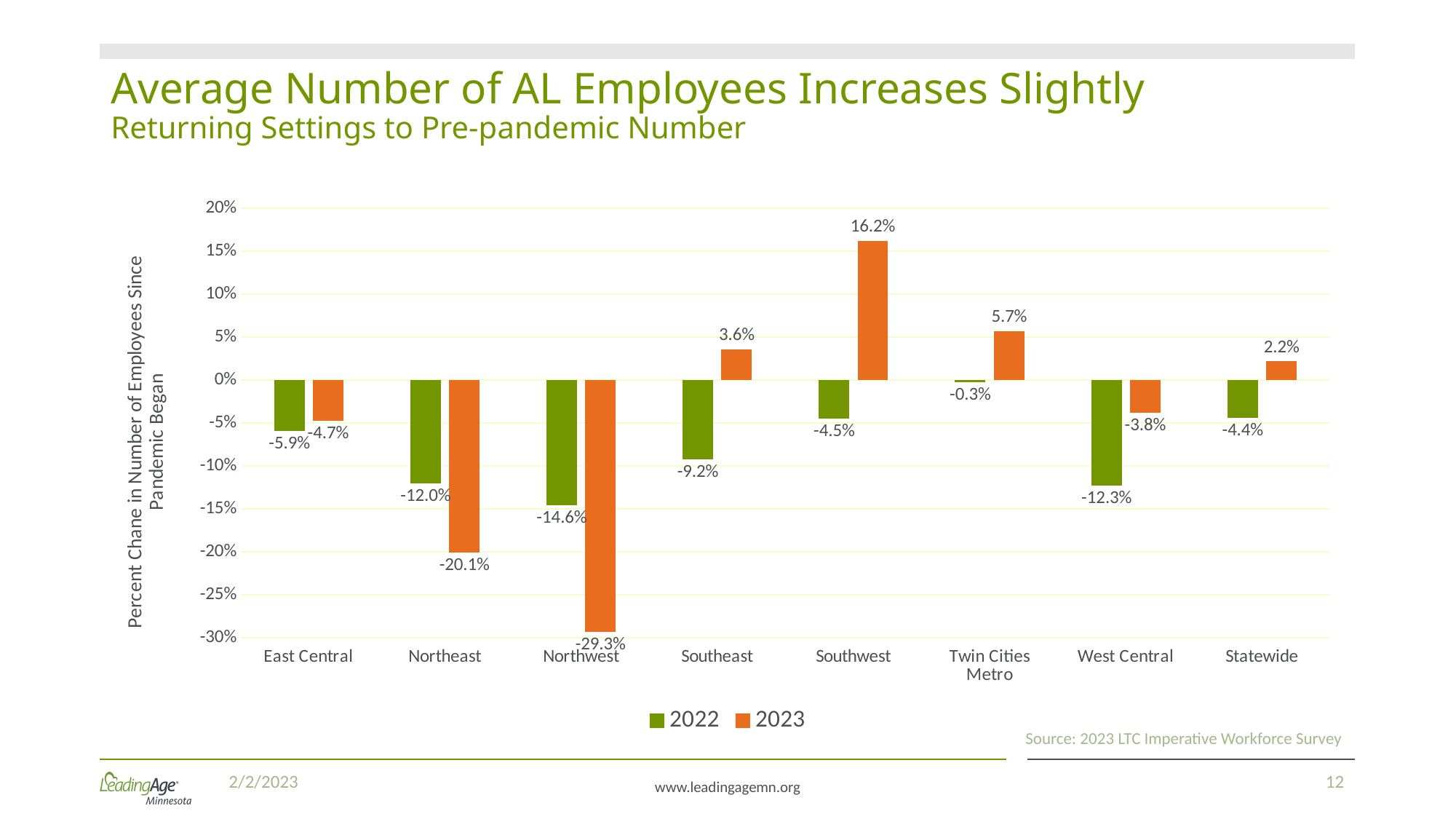
How many categories are shown on the x axis? 8 How many series does the legend list? 2 What is the difference between the 2022 and 2023 values for Northeast? 8.1 percentage points Which category has the highest 2023 value? Southwest What is the 2023 value for Statewide? 2.2% What is the 2022 value for Twin Cities Metro? -0.3% Which category has the lowest 2023 value? Northwest Which category has the lowest 2022 value? Northwest What is the 2023 value for Southwest? 16.2% What is the 2022 value for Northwest? -14.6% What kind of chart is shown on the slide? Bar chart Which is larger, the 2023 value for Southeast or the 2023 value for Twin Cities Metro? Twin Cities Metro